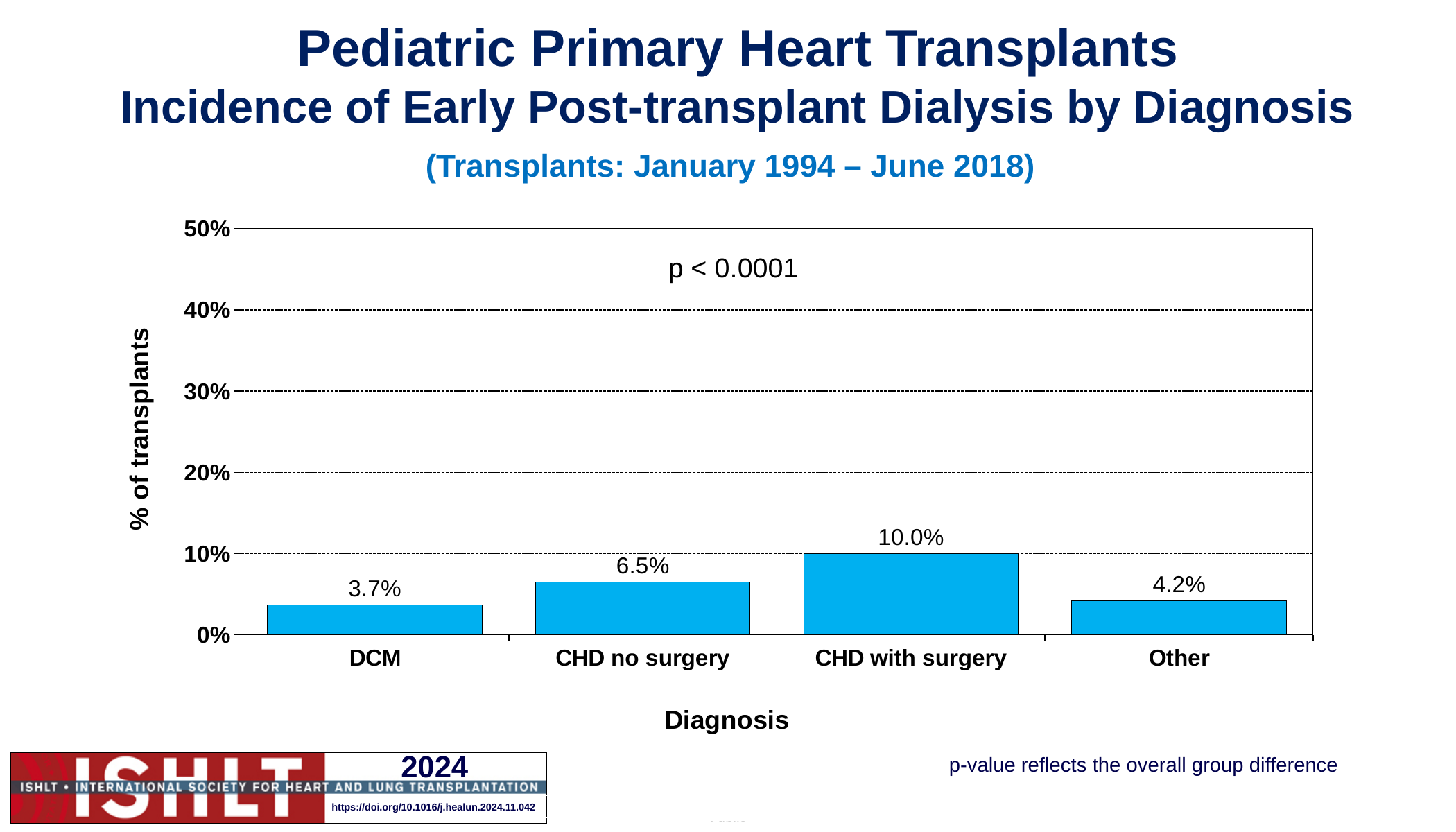
What is the incidence of early post-transplant dialysis for DCM? 3.7% What p-value is printed on the chart? p < 0.0001 How many diagnosis categories are shown on the x axis? 4 What is the value shown for CHD no surgery? 6.5% Which diagnosis has the lowest incidence of early post-transplant dialysis? DCM Which diagnosis has the highest incidence of early post-transplant dialysis? CHD with surgery Which is larger, the value for CHD no surgery or the value for Other? CHD no surgery Is the value for CHD no surgery greater or less than 10%? less What is the difference between the values for CHD with surgery and DCM? 6.3% What is the value shown for the Other diagnosis group? 4.2% What kind of chart is shown on the slide? bar chart What is the value shown for CHD with surgery? 10.0%